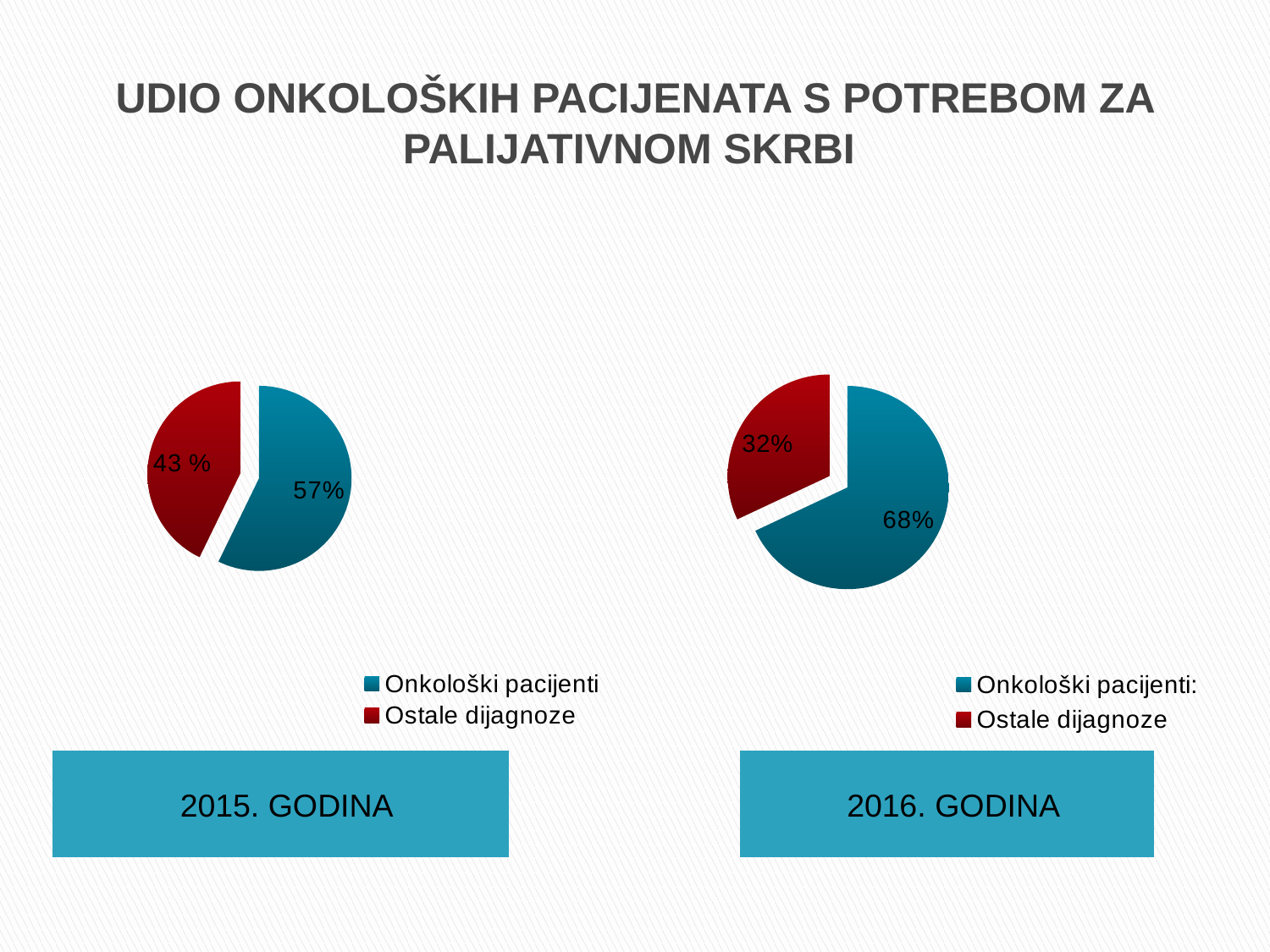
In the right pie chart (2016. GODINA), what is the share for Onkološki pacijenti? 68% In the left pie chart (2015. GODINA), what colour is the Ostale dijagnoze slice? Red What kind of chart is used on this slide? Pie chart In the right pie chart (2016. GODINA), what is the difference between the Onkološki pacijenti share and the Ostale dijagnoze share? 36% Which is larger: the Onkološki pacijenti share in the left pie chart (2015) or in the right pie chart (2016)? 2016 How many entries does the legend of the right pie chart (2016. GODINA) list? 2 In the left pie chart (2015. GODINA), which slice is the smallest? Ostale dijagnoze How many slices does the left pie chart (2015. GODINA) have? 2 In the right pie chart (2016. GODINA), which slice is the largest? Onkološki pacijenti In the left pie chart (2015. GODINA), what is the share for Ostale dijagnoze? 43 % In the left pie chart (2015. GODINA), what is the share for Onkološki pacijenti? 57% In the right pie chart (2016. GODINA), what is the share for Ostale dijagnoze? 32%